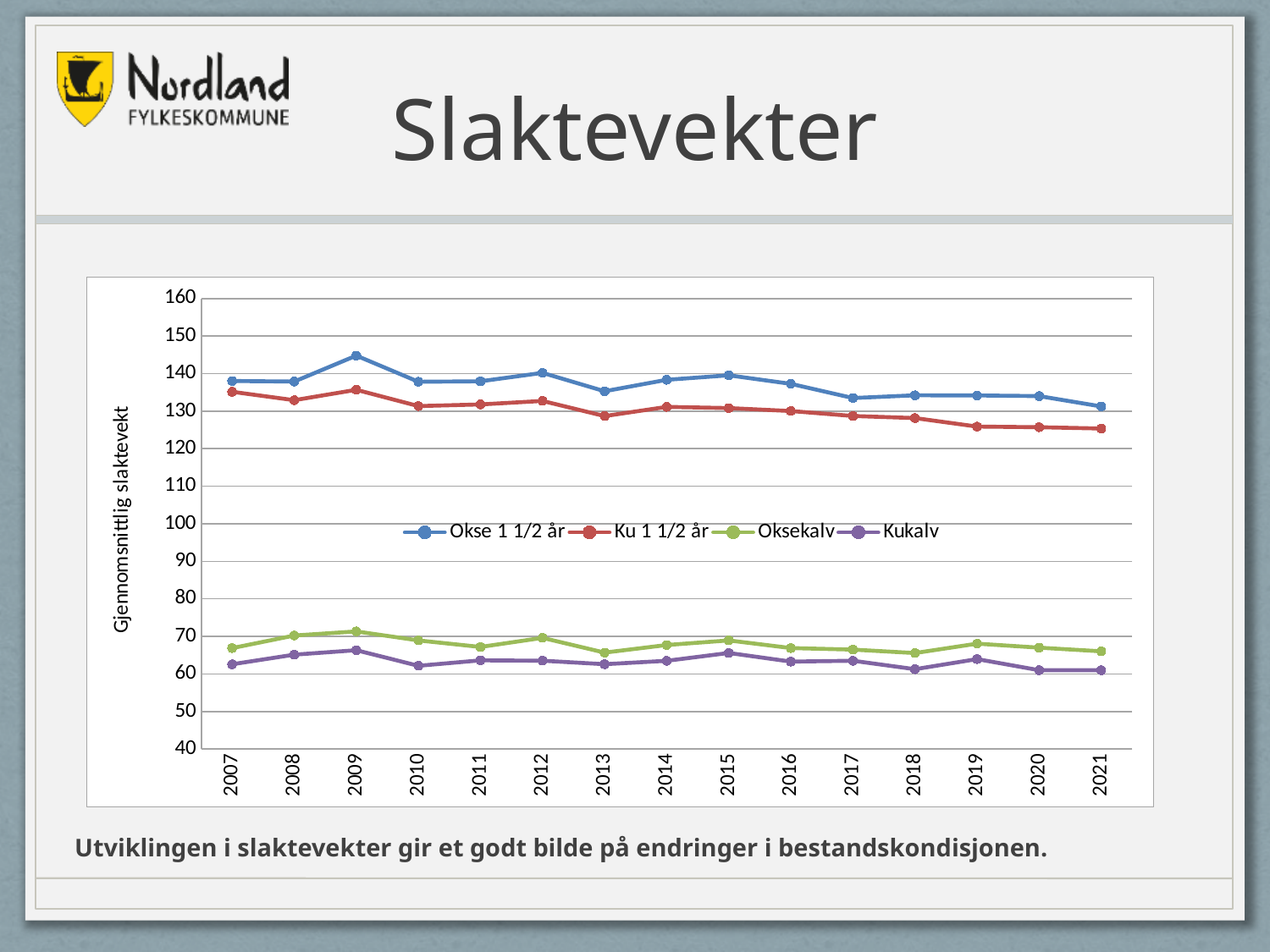
Does the value for Ku 1 1/2 år rise or fall overall from 2007 to 2021? Fall In 2010, which is larger: the value for Oksekalv or the value for Kukalv? Oksekalv Which series is drawn in purple? Kukalv How many series does the legend list? 4 What is the label on the vertical axis of the chart? Gjennomsnittlig slaktevekt How many years are plotted along the x axis? 15 Is the value for Ku 1 1/2 år in 2021 greater or less than 130? less Is the value for Oksekalv in 2007 greater or less than 70? less In which year is the value for Okse 1 1/2 år highest? 2009 What kind of chart is shown on the slide? Line chart Is the value for Okse 1 1/2 år in 2009 greater or less than 140? greater